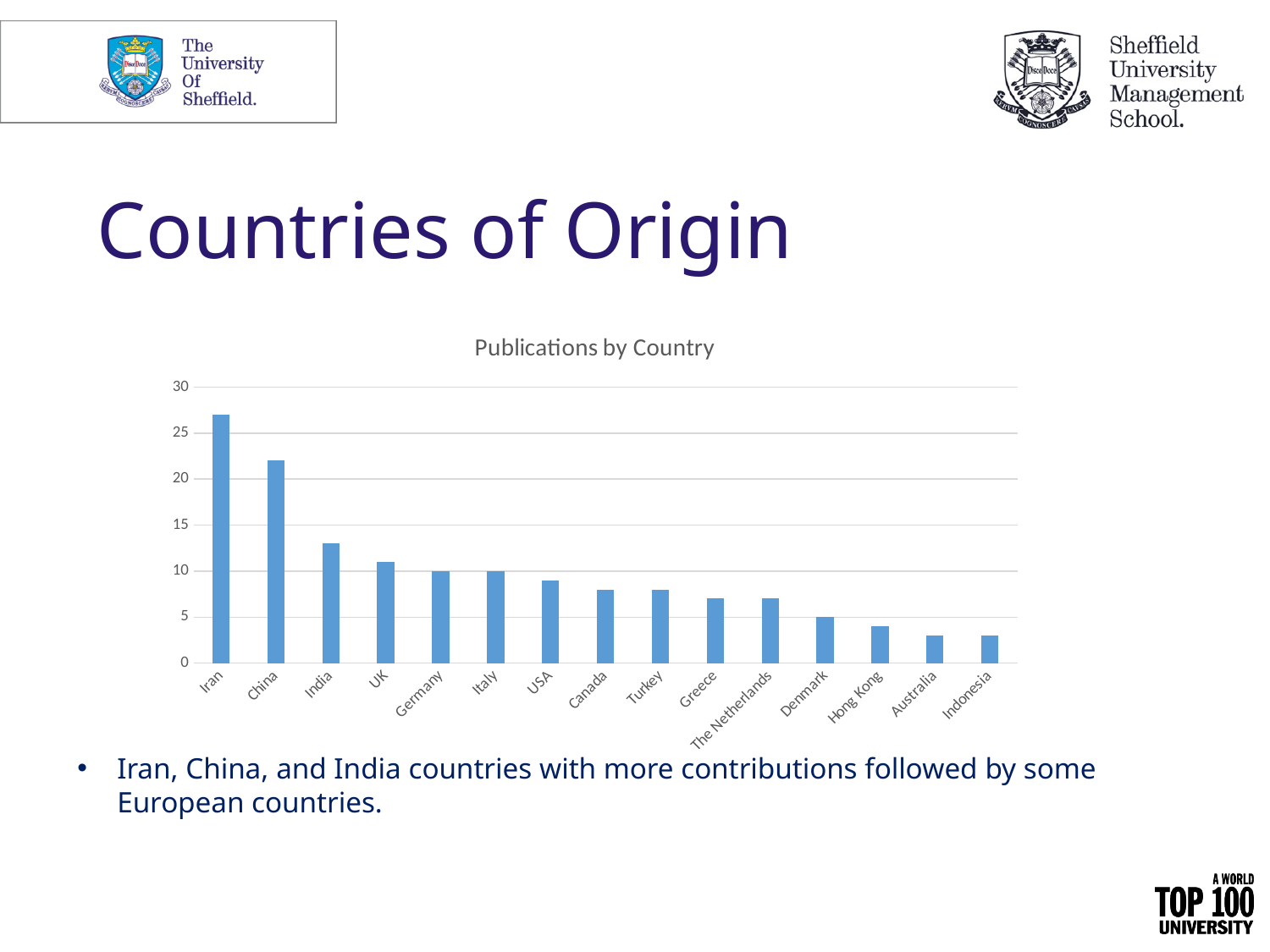
What is the title of the chart? Publications by Country Is the value for Iran greater or less than 25? greater Is the value for USA greater or less than 10? less Is the value for India greater or less than 10? greater Which country has the highest number of publications? Iran How many countries are shown on the x axis of the chart? 15 Which has more publications, Iran or China? Iran Which has more publications, India or the UK? India What kind of chart is shown on the slide? bar chart Do the values rise or fall moving from left to right along the x axis? fall